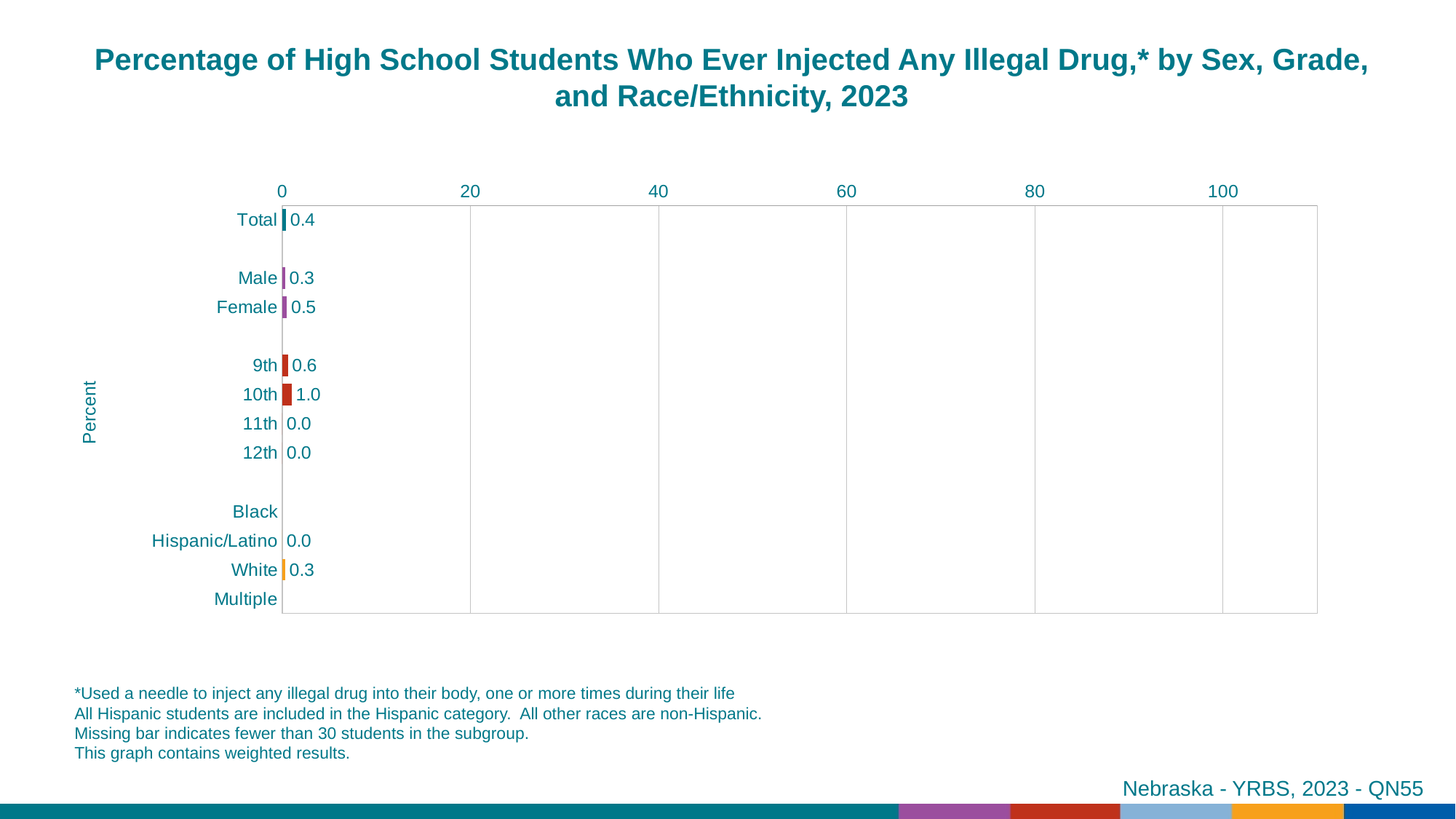
What kind of chart is shown on the slide? bar chart Which is larger, the value for Male or the value for Female? Female Which category has the highest value? 10th Which categories have no bar shown? Black and Multiple What is the value for Female? 0.5 What is the value for Total? 0.4 What is the difference between the values for 10th and 9th grade? 0.4 How many categories are listed on the vertical axis? 12 Is the value for 10th grade greater or less than 20? less What is the value for 10th grade? 1.0 What is the value for White? 0.3 What is the label on the vertical axis? Percent